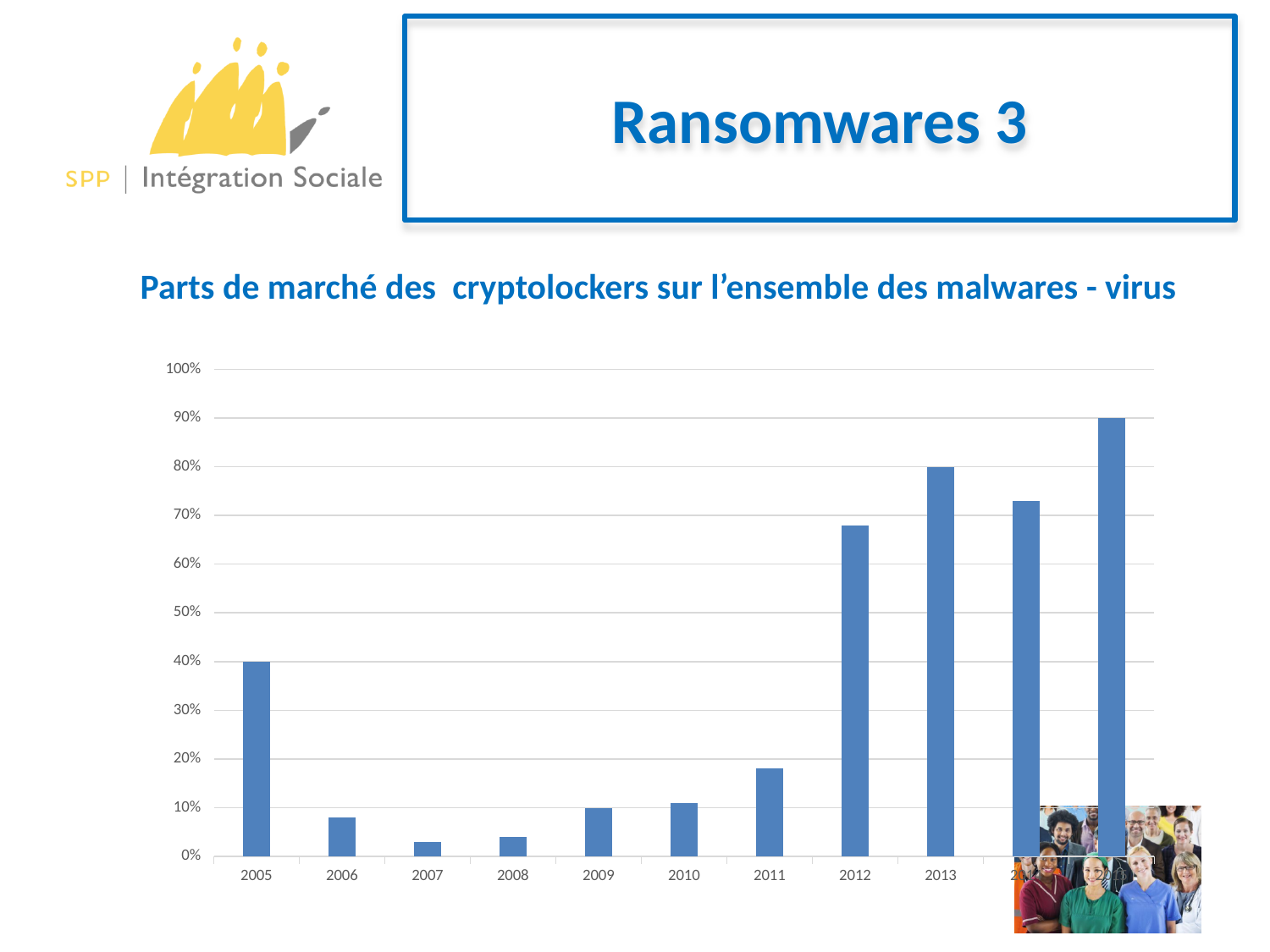
Which is larger, the value for 2012 or the value for 2005? 2012 Between 2008 and 2013, do the values rise or fall? rise What kind of chart is shown on the slide? bar chart What is the value for 2005? 40% Which is larger, the value for 2011 or the value for 2006? 2011 Is the value for 2011 greater or less than 20%? less Is the value for 2012 greater or less than 60%? greater Is the value for 2010 greater or less than 20%? less What is the title of the chart? Parts de marché des cryptolockers sur l'ensemble des malwares - virus What is the value for 2013? 80% What is the value for 2009? 10%